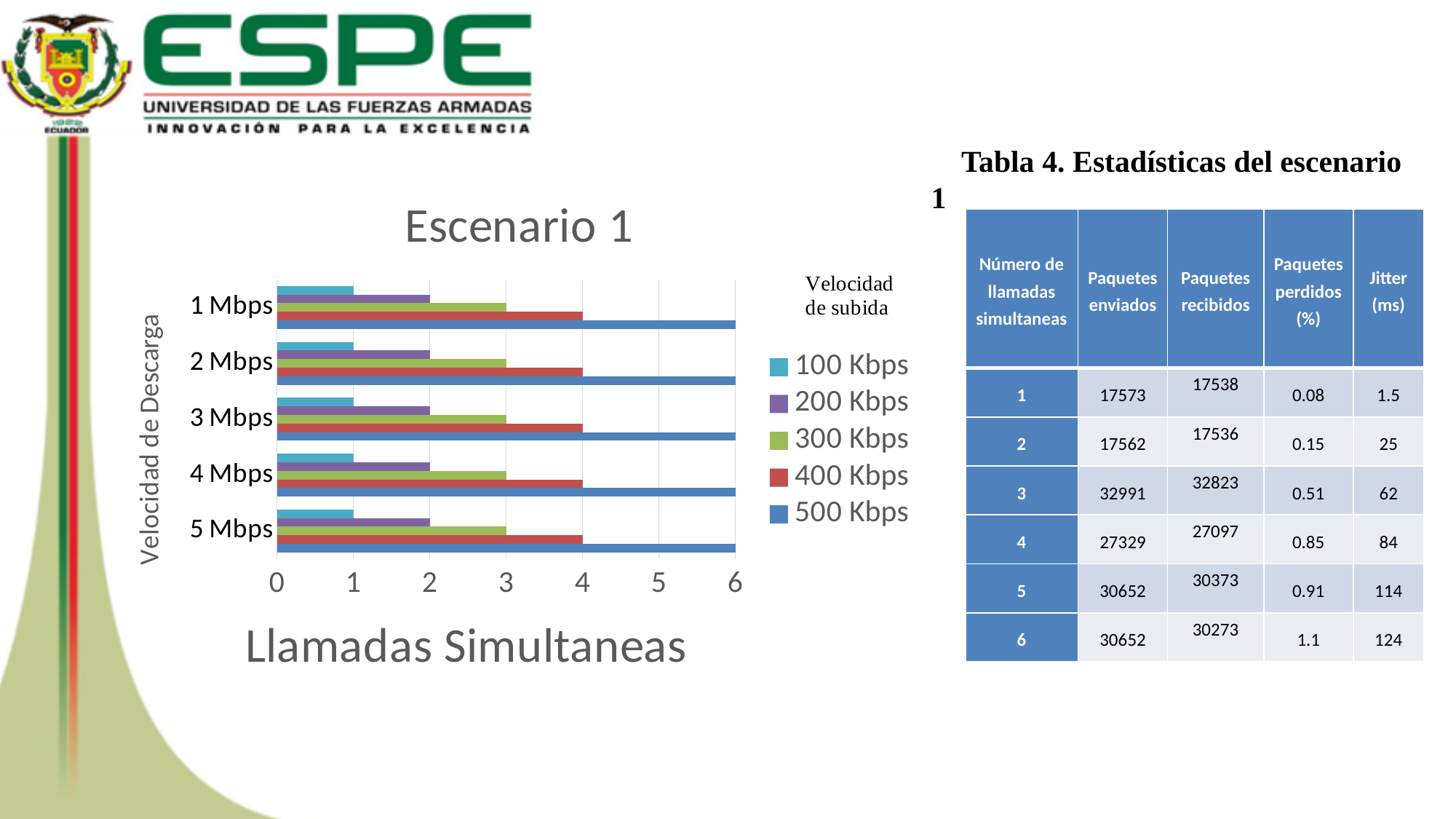
In the "Escenario 1" chart, which upload-speed series has the lowest value for 2 Mbps? 100 Kbps In the "Escenario 1" chart, which upload-speed series has the highest value for 4 Mbps? 500 Kbps What is the x-axis title of the "Escenario 1" chart? Llamadas Simultaneas In the "Escenario 1" chart, what is the value of the 300 Kbps series for 5 Mbps? 3 How many series does the legend of the "Escenario 1" chart list? 5 In the "Escenario 1" chart, what is the difference between the 500 Kbps and 400 Kbps values for 1 Mbps? 2 How many download-speed categories are shown on the y axis of the "Escenario 1" chart? 5 What type of chart is shown under the title "Escenario 1"? bar chart In the "Escenario 1" chart, what is the value of the 100 Kbps series for 3 Mbps? 1 In the "Escenario 1" chart, what is the value of the 400 Kbps series for 2 Mbps? 4 In the "Escenario 1" chart, what is the value of the 500 Kbps series for 1 Mbps? 6 In the "Escenario 1" chart, is the 300 Kbps value for 3 Mbps larger or smaller than the 200 Kbps value for 3 Mbps? larger